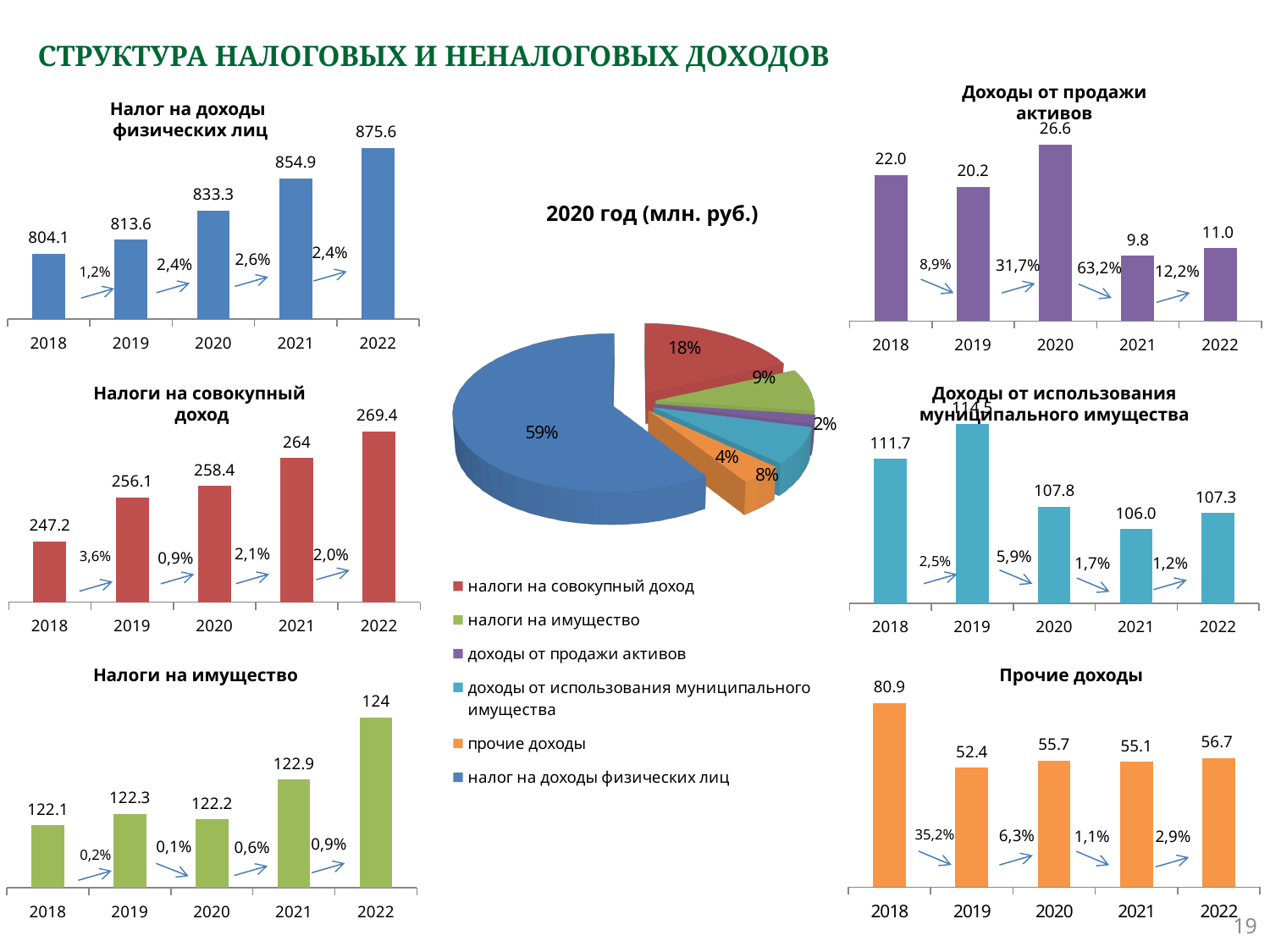
In the chart 'Налоги на совокупный доход', what is the difference between the 2022 and 2018 values? 22.2 In the chart 'Доходы от продажи активов', what is the value for 2020? 26.6 In the chart 'Налог на доходы физических лиц', do the values rise or fall from 2018 to 2022? rise In the chart 'Доходы от использования муниципального имущества', which is larger, the value for 2019 or the value for 2021? 2019 In the pie chart '2020 год (млн. руб.)', what share does 'налог на доходы физических лиц' have? 59% In the chart 'Прочие доходы', what is the value for 2018? 80.9 How many years are shown on the x axis of the chart 'Прочие доходы'? 5 In the chart 'Налоги на имущество', which year has the highest value? 2022 In the chart 'Доходы от продажи активов', which year has the lowest value? 2021 In the chart 'Налоги на имущество', what is the value for 2021? 122.9 In the chart 'Налог на доходы физических лиц', what is the value for 2022? 875.6 How many entries does the legend of the pie chart '2020 год (млн. руб.)' list? 6